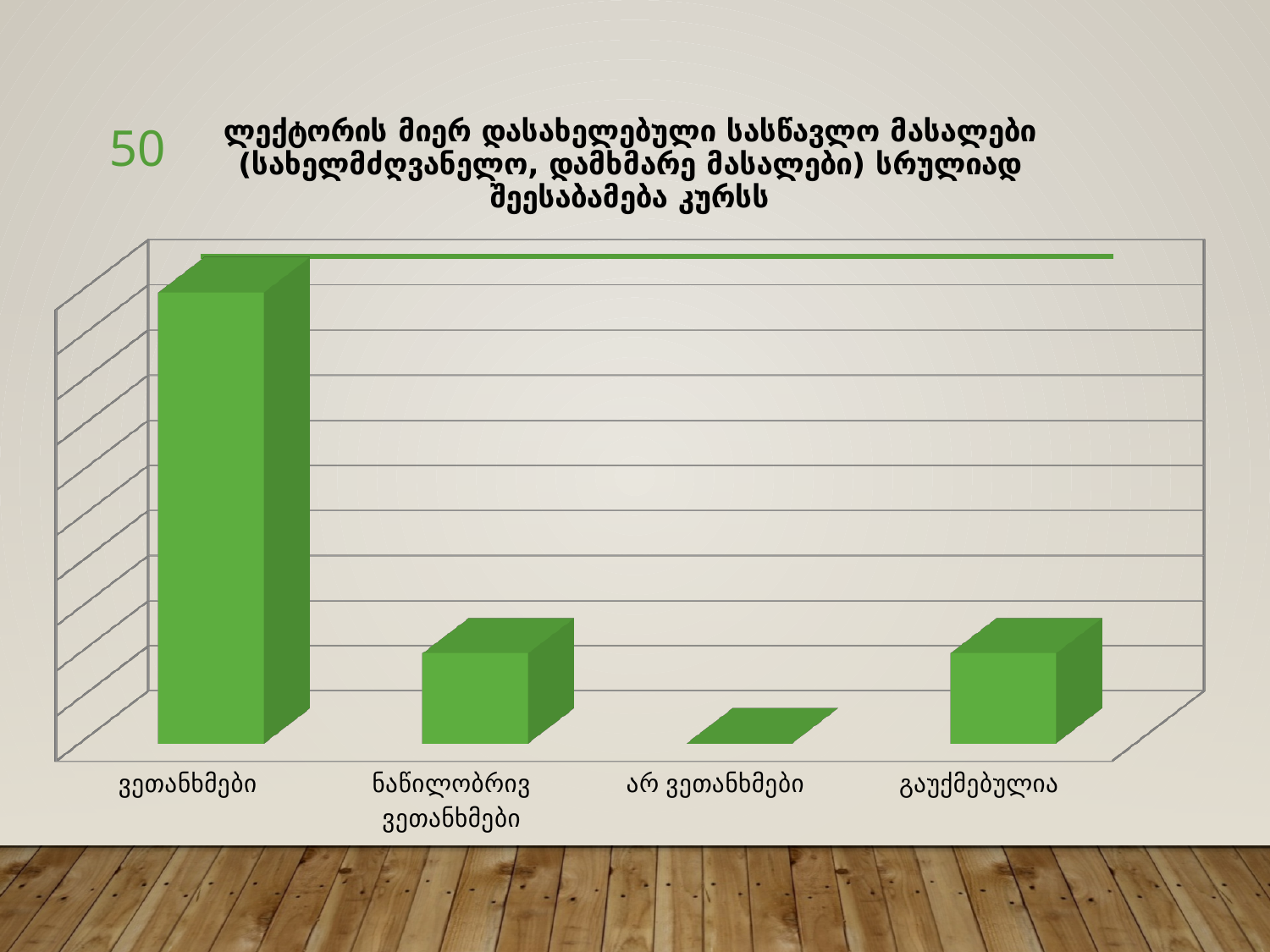
What is the title of the chart? ლექტორის მიერ დასახელებული სასწავლო მასალები (სახელმძღვანელო, დამხმარე მასალები) სრულიად შეესაბამება კურსს What colour are the bars in the chart? green Which is larger, the value for ვეთანხმები or the value for ნაწილობრივ ვეთანხმები? ვეთანხმები Which category has the highest bar in the chart? ვეთანხმები Which is larger, the value for ვეთანხმები or the value for გაუქმებულია? ვეთანხმები What is the label of the third category from the left on the x axis? არ ვეთანხმები Which is larger, the value for გაუქმებულია or the value for არ ვეთანხმები? გაუქმებულია Which category has the lowest bar in the chart? არ ვეთანხმები How many categories are shown on the x axis of the chart? 4 What kind of chart is shown on the slide? bar chart